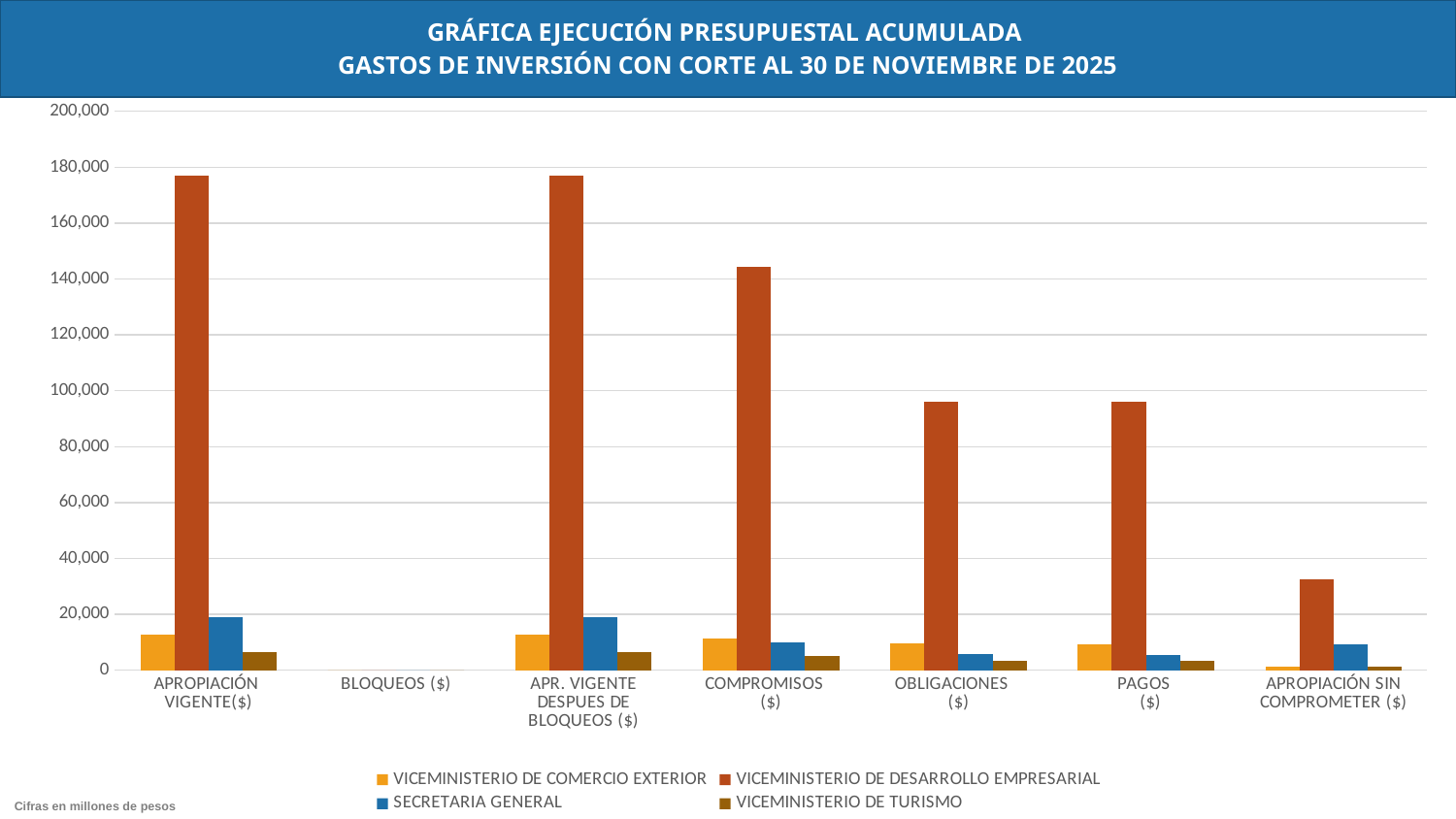
According to the note at the bottom left, in what units are the figures expressed? Millones de pesos Which category shows no visible bars for any series? BLOQUEOS ($) Is the value for VICEMINISTERIO DE DESARROLLO EMPRESARIAL in COMPROMISOS ($) greater or less than 120,000? greater In PAGOS ($), which is larger: VICEMINISTERIO DE COMERCIO EXTERIOR or VICEMINISTERIO DE TURISMO? VICEMINISTERIO DE COMERCIO EXTERIOR Is the value for VICEMINISTERIO DE DESARROLLO EMPRESARIAL in OBLIGACIONES ($) greater or less than 100,000? less Is the value for VICEMINISTERIO DE DESARROLLO EMPRESARIAL in APROPIACIÓN SIN COMPROMETER ($) greater or less than 20,000? greater What kind of chart is shown on the slide? Bar chart How many categories are shown along the x axis? 7 How many series does the legend list? 4 In COMPROMISOS ($), which is larger: VICEMINISTERIO DE DESARROLLO EMPRESARIAL or SECRETARIA GENERAL? VICEMINISTERIO DE DESARROLLO EMPRESARIAL